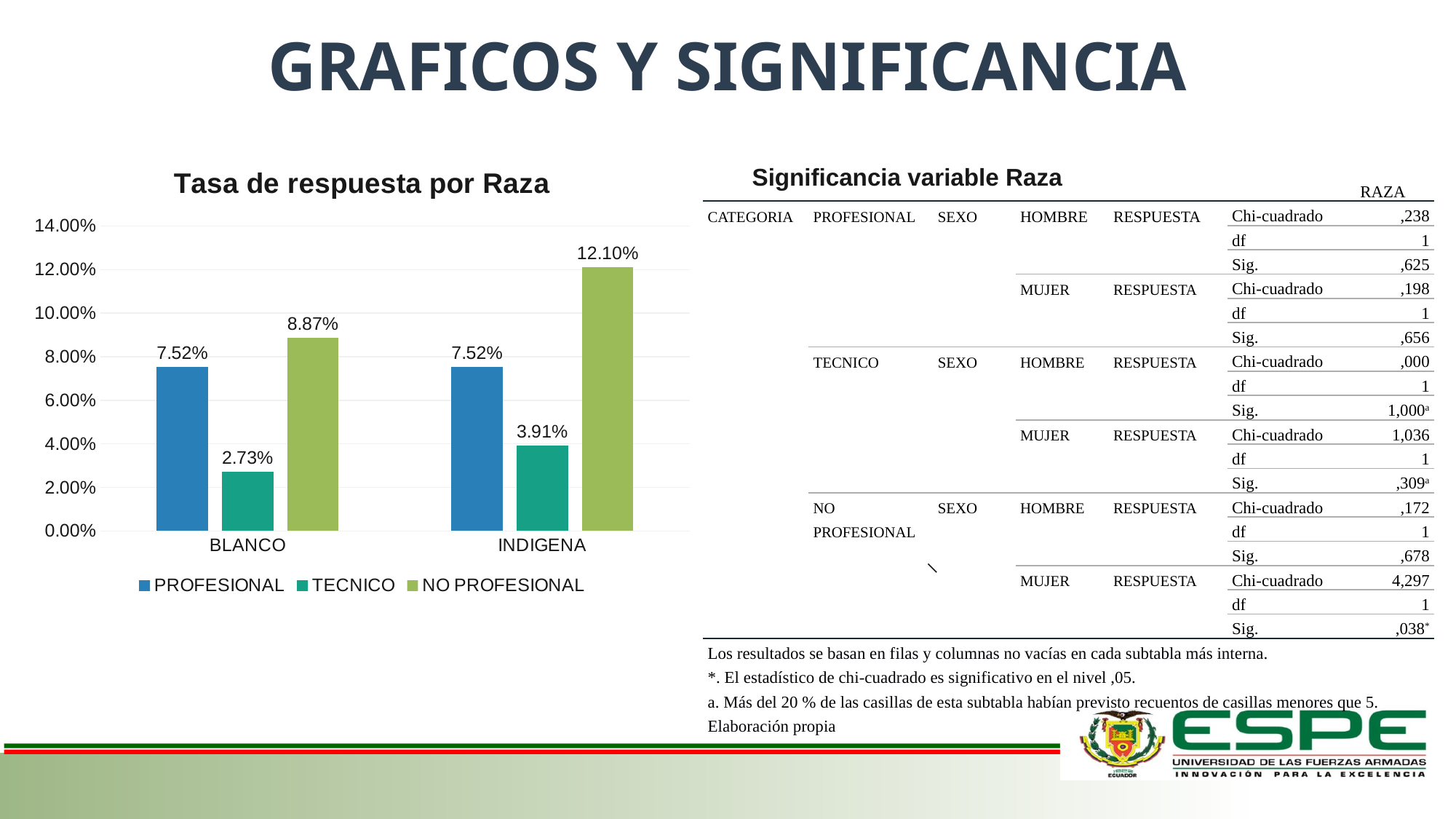
Is the value for NO PROFESIONAL in the INDIGENA category greater or less than 10.00%? greater What is the value for NO PROFESIONAL in the BLANCO category? 8.87% What is the difference between the NO PROFESIONAL values for INDIGENA and BLANCO? 3.23% What is the value for NO PROFESIONAL in the INDIGENA category? 12.10% What is the value for TECNICO in the BLANCO category? 2.73% What kind of chart is shown on the slide? bar chart How many categories are shown on the x axis of the chart? 2 Which series has the highest value in the INDIGENA category? NO PROFESIONAL Which is larger: the TECNICO value for INDIGENA or the TECNICO value for BLANCO? INDIGENA What is the value for PROFESIONAL in the INDIGENA category? 7.52% Which series has the lowest value in the BLANCO category? TECNICO How many series does the chart legend list? 3